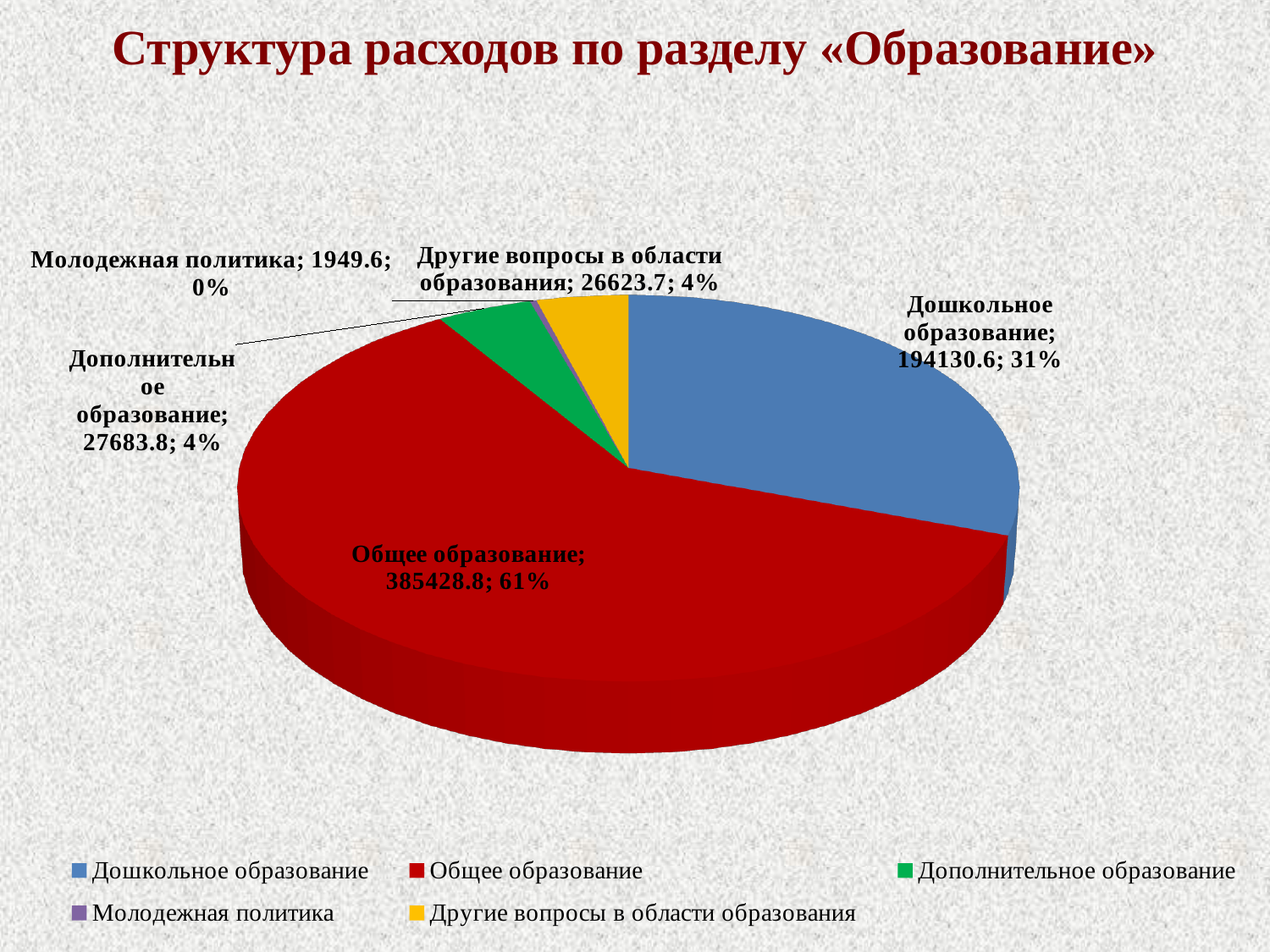
What is the title of the chart? Структура расходов по разделу «Образование» What is the difference between the values for Общее образование and Дошкольное образование? 191298.2 Which is larger, the value for Дошкольное образование or the value for Дополнительное образование? Дошкольное образование Which category has the smallest slice of the pie? Молодежная политика What share of the pie does Другие вопросы в области образования represent? 4% What is the value shown for Общее образование? 385428.8 What is the value shown for Молодежная политика? 1949.6 How many categories does the pie chart have? 5 What is the value shown for Дополнительное образование? 27683.8 What kind of chart is shown on the slide? Pie chart What share of the pie does Дошкольное образование represent? 31% Which category has the largest slice of the pie? Общее образование